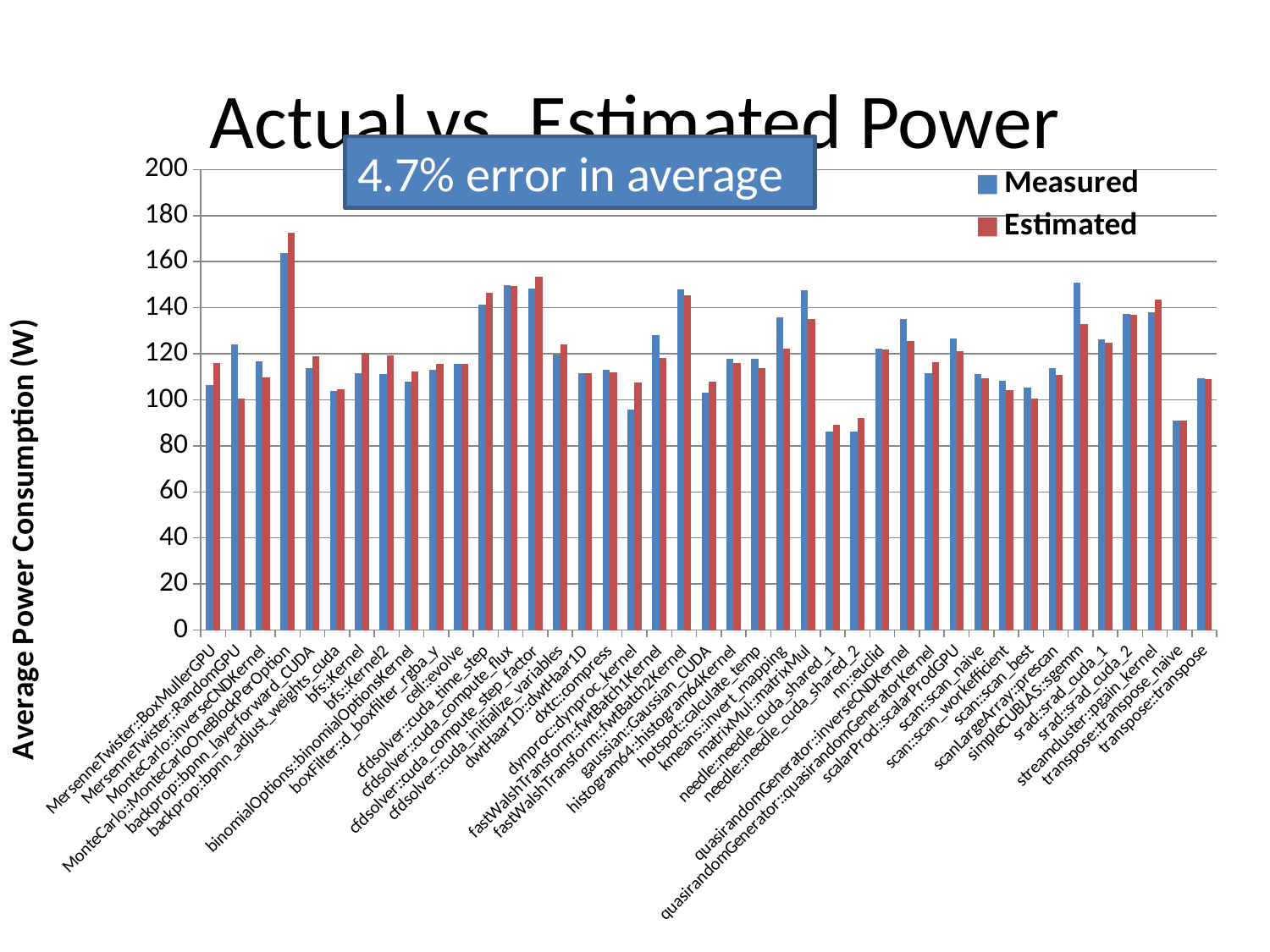
What average error does the text box on the chart report? 4.7% error in average Is the Measured value for transpose::transpose_naive greater or less than 100? less Is the Estimated value for MonteCarlo::MonteCarloOneBlockPerOption greater or less than 160? greater Is the Estimated value for cfdsolver::cuda_compute_step_factor greater or less than 140? greater How many series does the legend list? 2 Which category has the highest Estimated value? MonteCarlo::MonteCarloOneBlockPerOption For dynproc::dynproc_kernel, which is larger, the Measured or the Estimated value? Estimated What kind of chart is shown on the slide? bar chart What is the title of the vertical axis? Average Power Consumption (W) Which category has the highest Measured value? MonteCarlo::MonteCarloOneBlockPerOption For simpleCUBLAS::sgemm, which is larger, the Measured or the Estimated value? Measured